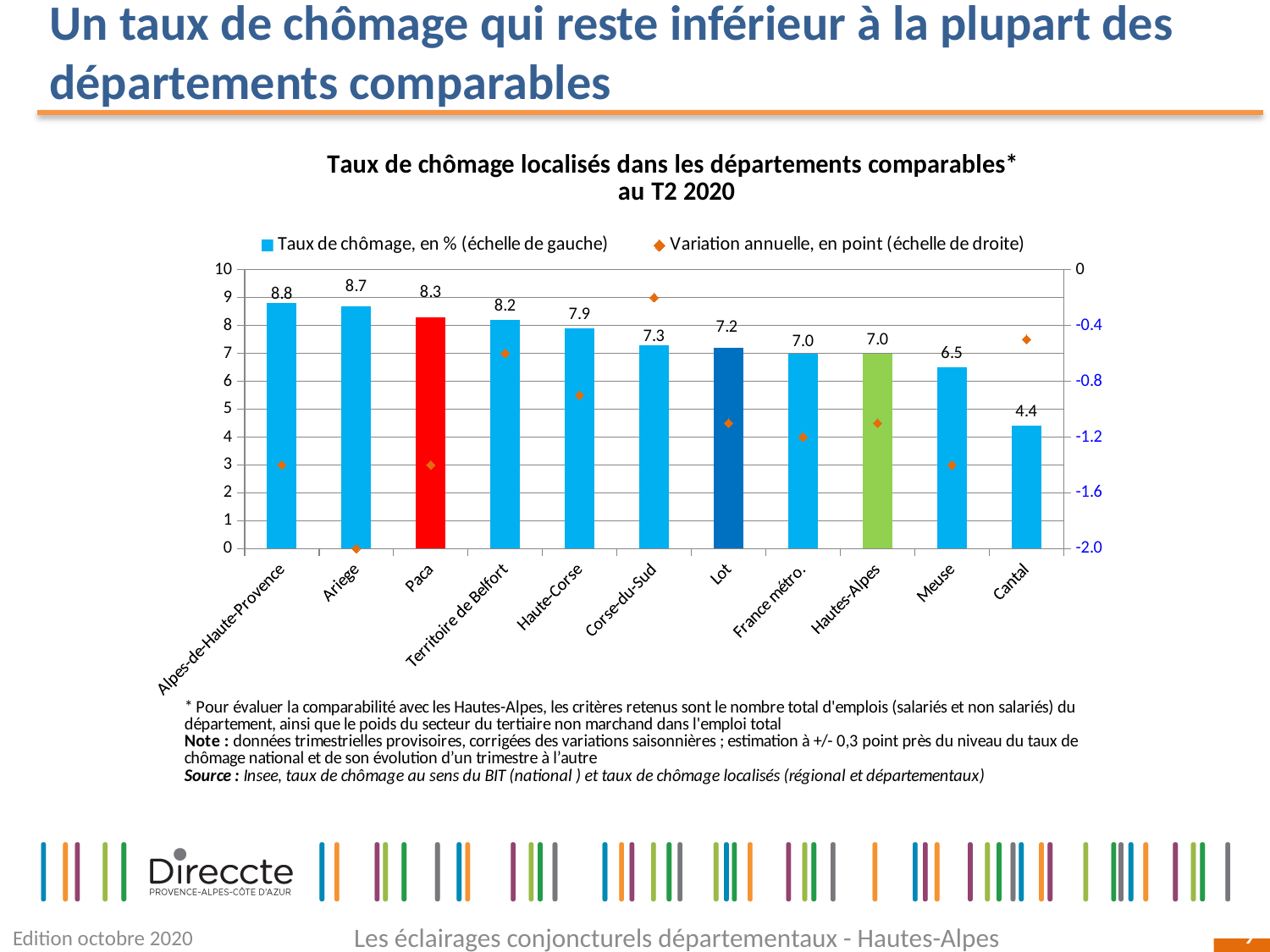
What type of chart is used to show the unemployment rates? Bar chart Is the annual variation (right axis) for Ariege greater or less than -1.6? less Which has the higher unemployment rate, Haute-Corse or Corse-du-Sud? Haute-Corse What is the unemployment rate shown for Meuse? 6.5 Which department has the highest unemployment rate in the chart? Alpes-de-Haute-Provence Which department has the lowest unemployment rate in the chart? Cantal Which category's bar is coloured red in the chart? Paca How many departments or territories are shown on the x axis of the chart? 11 Is the annual variation (right axis) for Cantal greater or less than -0.8? greater What is the difference between the unemployment rate of Alpes-de-Haute-Provence and that of Cantal? 4.4 What is the unemployment rate shown for Hautes-Alpes? 7.0 How many series does the chart legend list? 2